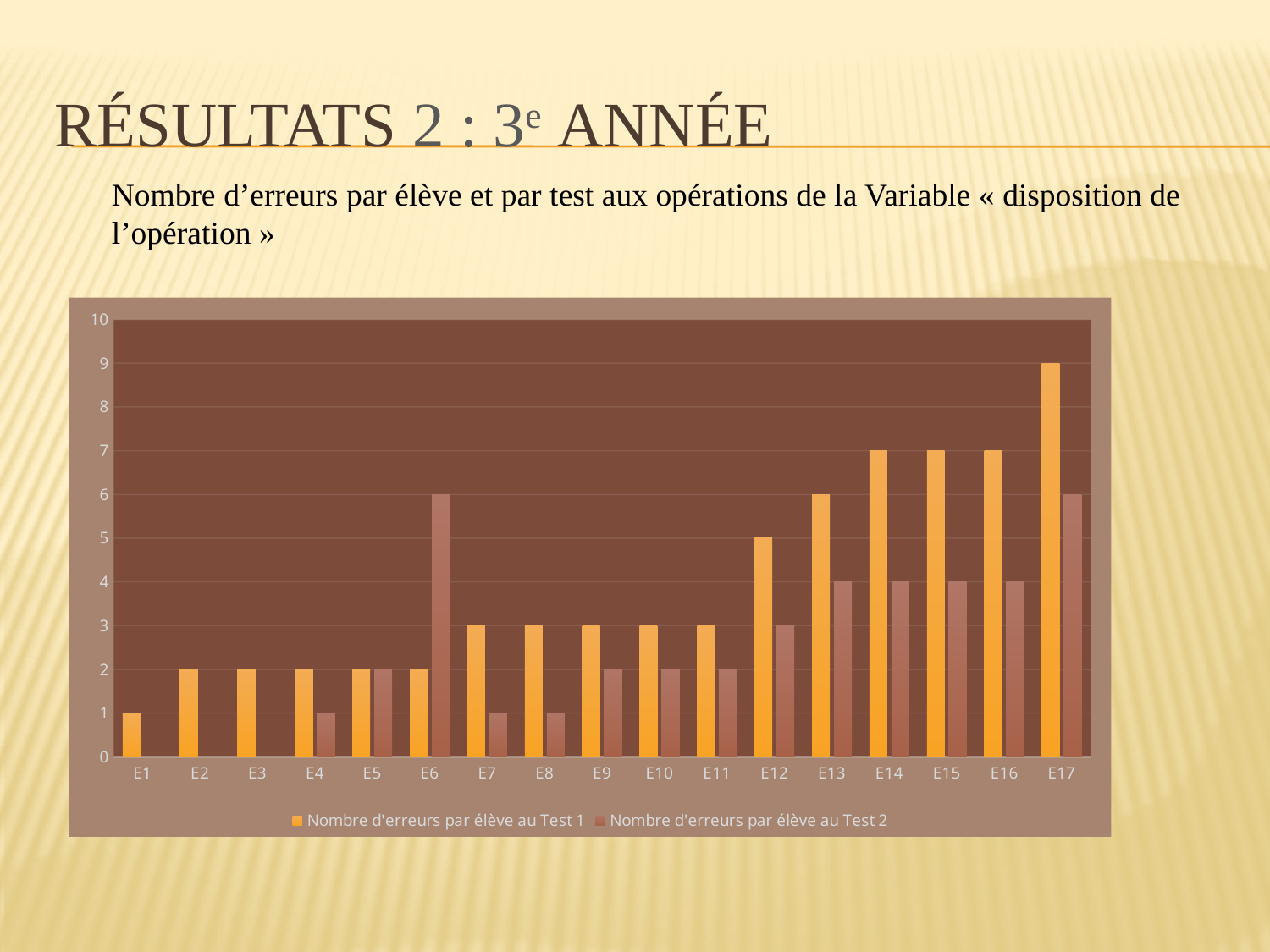
What is the difference between the Test 1 and Test 2 errors for E17? 3 Which student has the lowest number of errors at Test 1? E1 Which student has the highest number of errors at Test 1? E17 For E6, which is larger: the number of errors at Test 1 or at Test 2? Test 2 How many students (categories) are shown on the x axis? 17 What is the number of errors for E17 at Test 1? 9 How many series does the legend list? 2 What kind of chart is shown on the slide? Bar chart What is the label of the first series in the legend? Nombre d'erreurs par élève au Test 1 Do the Test 1 values generally rise or fall from E1 to E17? Rise Is the value for E12 at Test 1 greater or less than 4? greater What is the number of errors for E6 at Test 2? 6